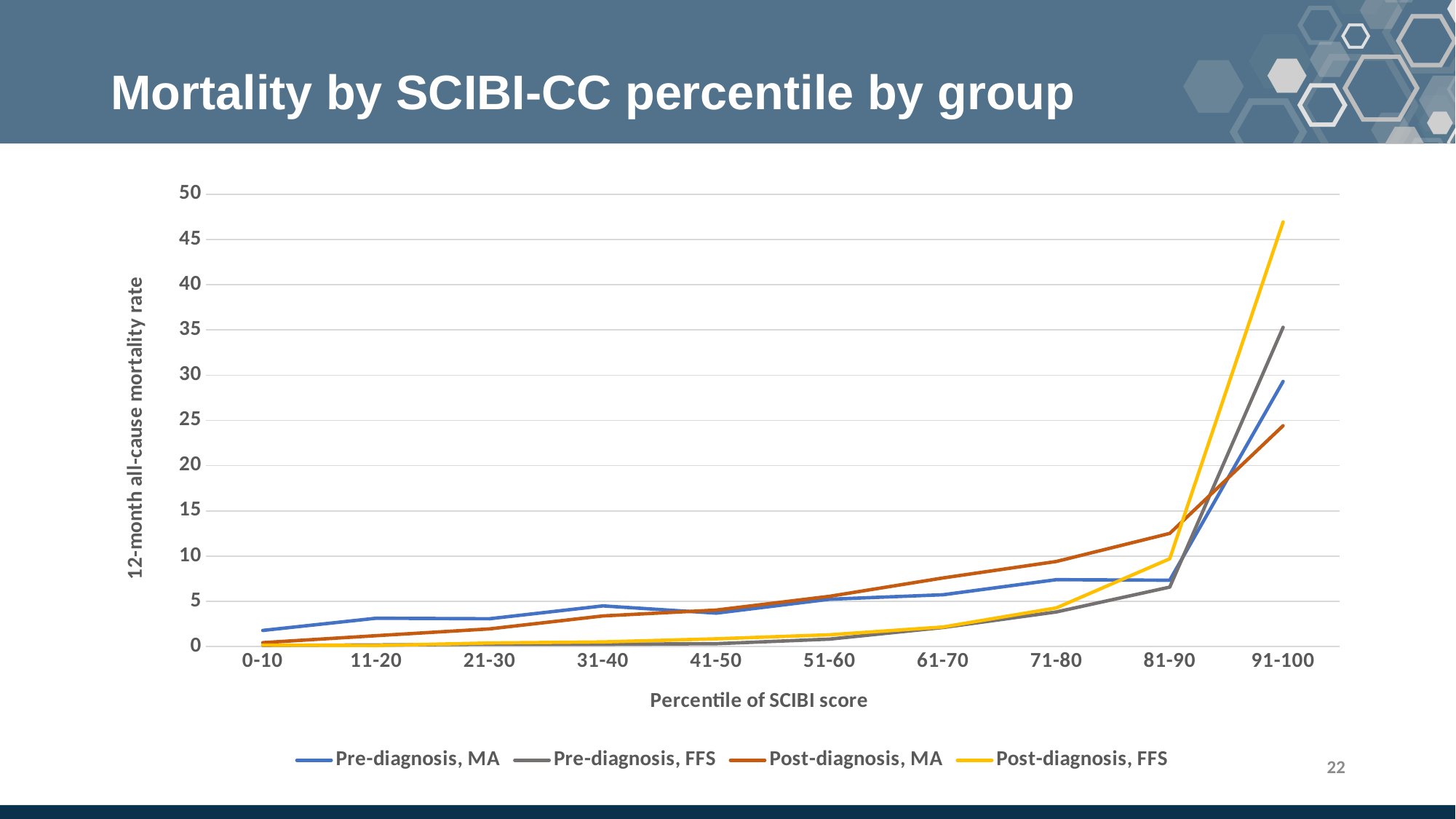
Is the value for Post-diagnosis, FFS at the 91-100 percentile greater or less than 40? greater Is the value for Pre-diagnosis, FFS at the 91-100 percentile greater or less than 30? greater Do the values for Post-diagnosis, FFS rise or fall as the percentile increases along the x axis? rise Is the value for Post-diagnosis, MA at the 81-90 percentile greater or less than 10? greater How many series does the legend list? 4 What kind of chart is shown on the slide? line chart What is the title of the y axis? 12-month all-cause mortality rate At the 71-80 percentile, which is larger: Post-diagnosis, MA or Pre-diagnosis, FFS? Post-diagnosis, MA Which series has the highest mortality rate at the 91-100 percentile? Post-diagnosis, FFS Which series has the lowest mortality rate at the 91-100 percentile? Post-diagnosis, MA How many percentile categories are shown on the x axis? 10